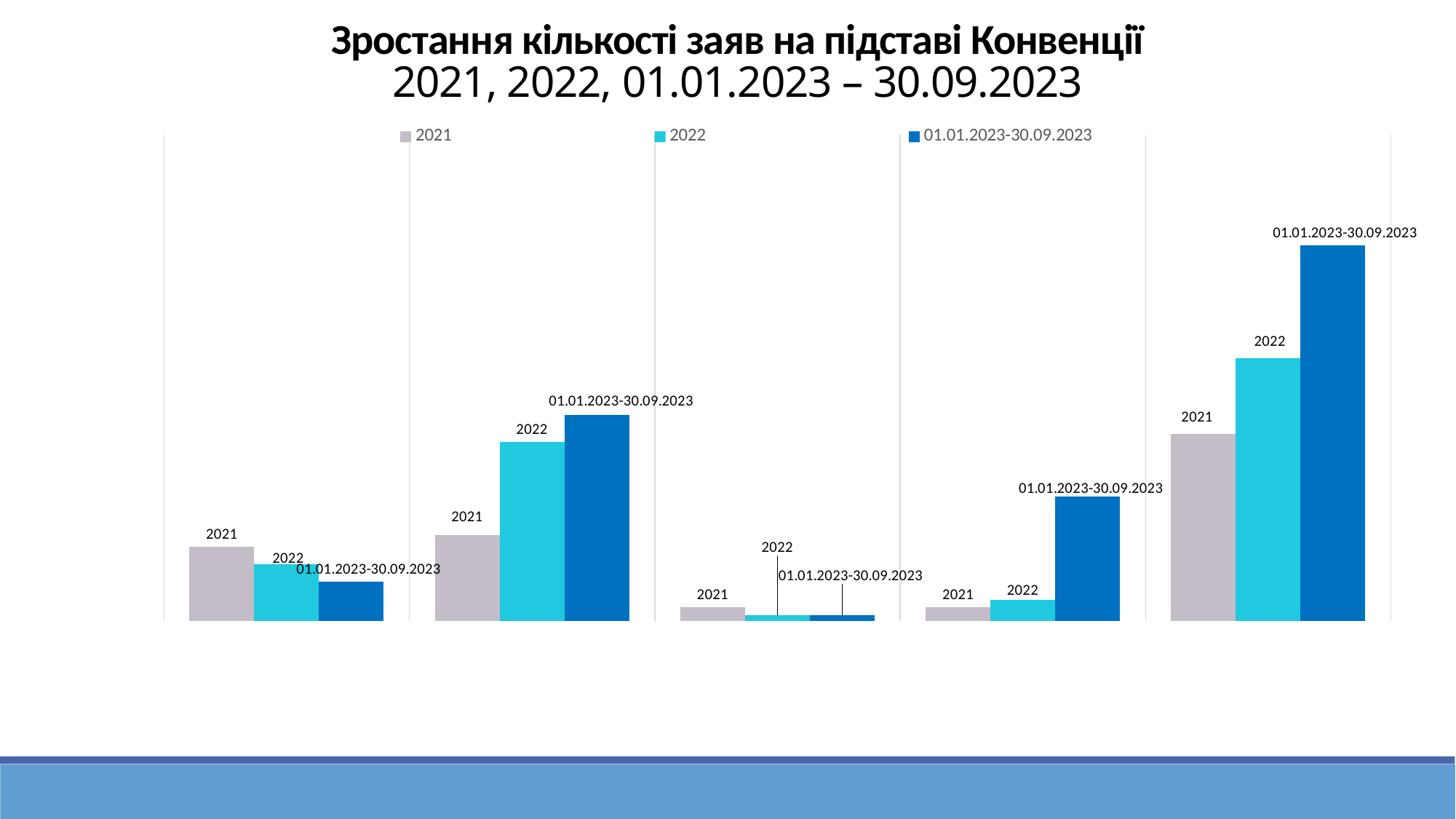
In the leftmost group of bars, which series has the highest bar? 2021 What kind of chart is shown on the slide? bar chart How many groups of bars are plotted in the chart? 5 In the second group of bars from the left, is the 2022 bar or the 2021 bar taller? 2022 In the rightmost group of bars, which series has the highest bar? 01.01.2023-30.09.2023 How many series does the legend list? 3 What are the three series listed in the legend? 2021, 2022, 01.01.2023-30.09.2023 Across the five groups, which group has the tallest bar overall? the rightmost group What is the title of the chart on the slide? Зростання кількості заяв на підставі Конвенції 2021, 2022, 01.01.2023 – 30.09.2023 In the rightmost group of bars, which series has the lowest bar? 2021 In the leftmost group of bars, which series has the lowest bar? 01.01.2023-30.09.2023 In the fourth group of bars from the left, is the 01.01.2023-30.09.2023 bar or the 2022 bar taller? 01.01.2023-30.09.2023